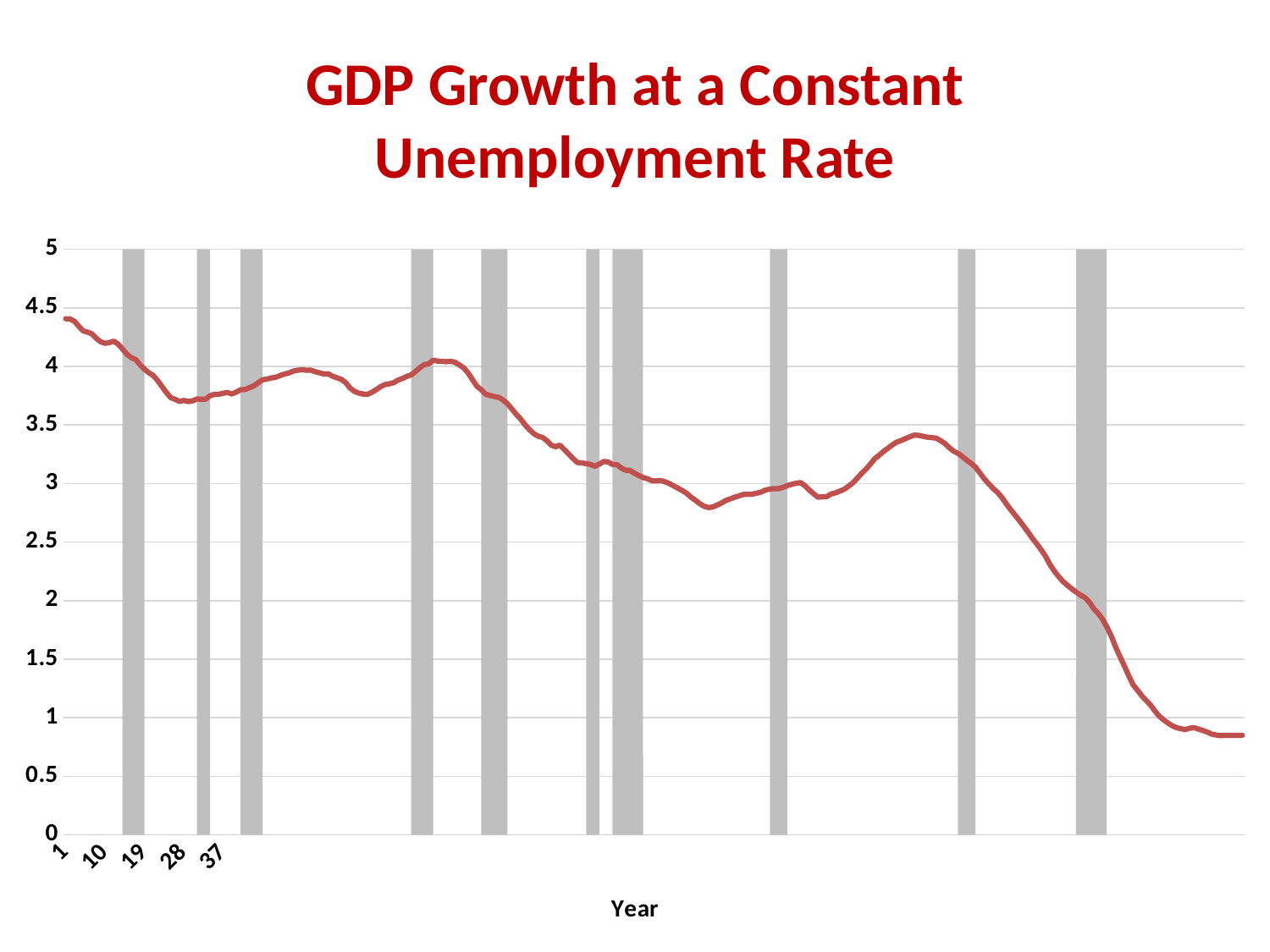
Is the value at year 10 greater or less than 4? greater Is the value at year 37 greater or less than 4? less Is the line's highest value at the left end or the right end of the chart? left end Is the value at year 1 greater or less than 4? greater What kind of chart is shown on the slide? line chart Overall, does the line rise or fall from left to right along the x axis? fall Is the line's lowest value at the left end or the right end of the chart? right end What is the label on the x axis of the chart? Year What is the title of the chart? GDP Growth at a Constant Unemployment Rate